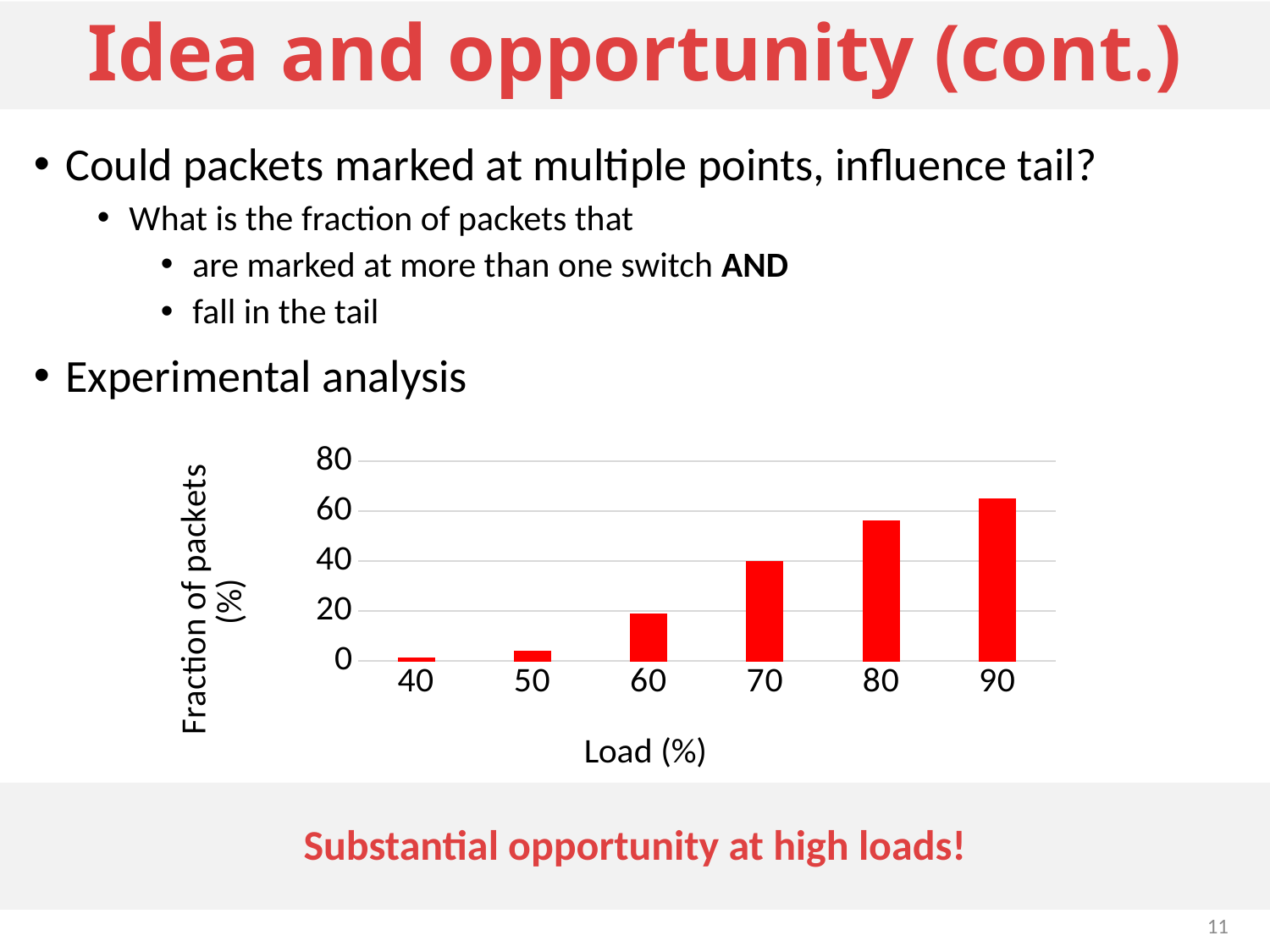
Is the fraction of packets at load 40 greater or less than 20? less Is the fraction of packets at load 80 greater or less than 40? greater Which has a larger fraction of packets, load 80 or load 90? 90 Is the fraction of packets at load 90 greater or less than 60? greater What kind of chart is shown on the slide? bar chart What is the title of the y axis of the chart? Fraction of packets (%) Do the values rise or fall as load increases along the x axis? rise What is the title of the x axis of the chart? Load (%) How many load values (bars) are plotted on the chart? 6 Which load value has the lowest fraction of packets? 40 Which load value has the highest fraction of packets? 90